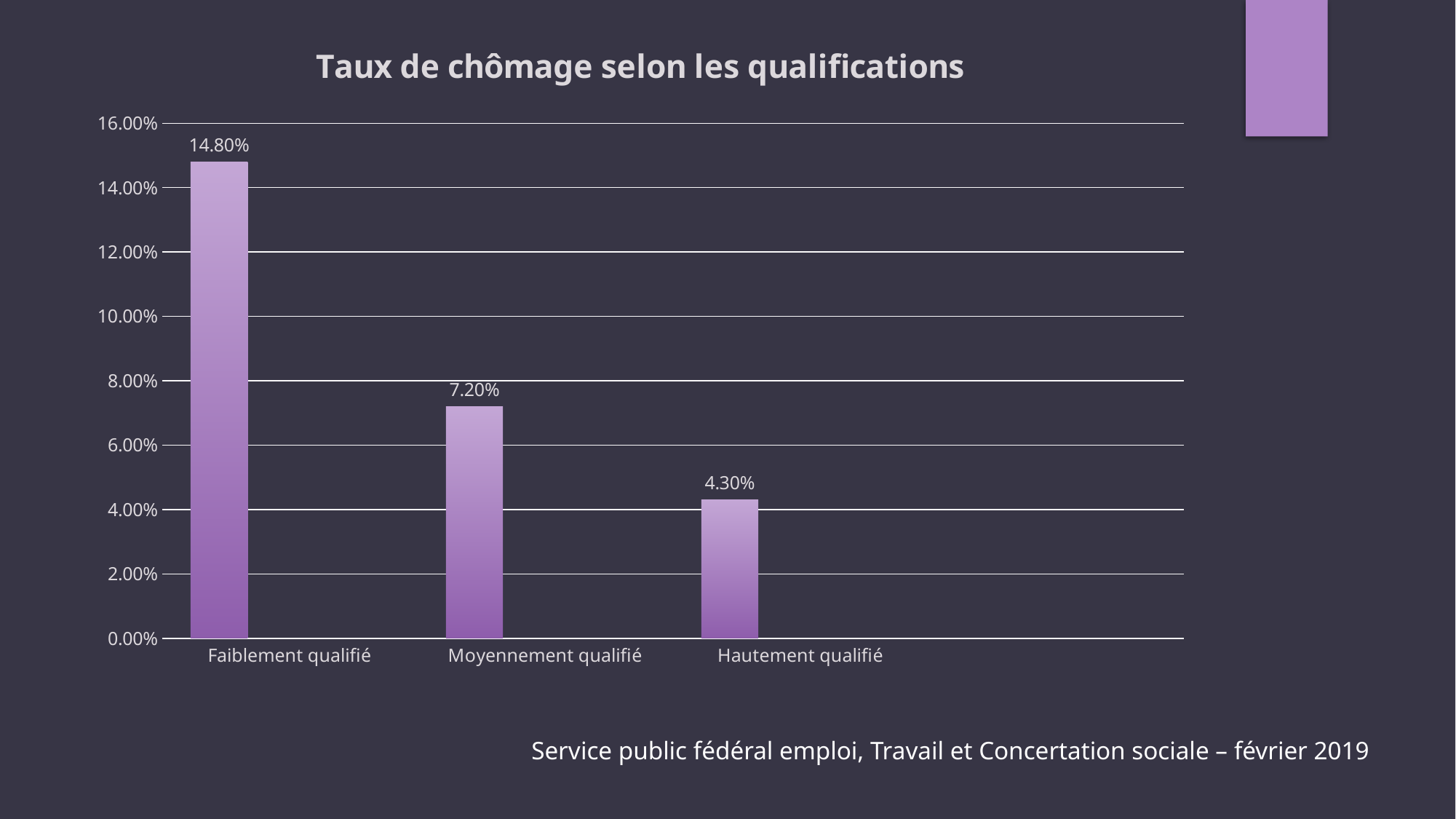
What is the title of the chart? Taux de chômage selon les qualifications Which qualification level has the lowest unemployment rate? Hautement qualifié How many qualification categories are shown in the chart? 3 What is the unemployment rate for Moyennement qualifié? 7.20% Which has a higher unemployment rate, Moyennement qualifié or Hautement qualifié? Moyennement qualifié What is the difference between the unemployment rates for Moyennement qualifié and Hautement qualifié? 2.90% What is the difference between the unemployment rates for Faiblement qualifié and Moyennement qualifié? 7.60% What kind of chart is shown on the slide? Bar chart Is the value for Faiblement qualifié greater or less than 14.00%? greater What is the unemployment rate for Faiblement qualifié? 14.80% Which qualification level has the highest unemployment rate? Faiblement qualifié What is the unemployment rate for Hautement qualifié? 4.30%